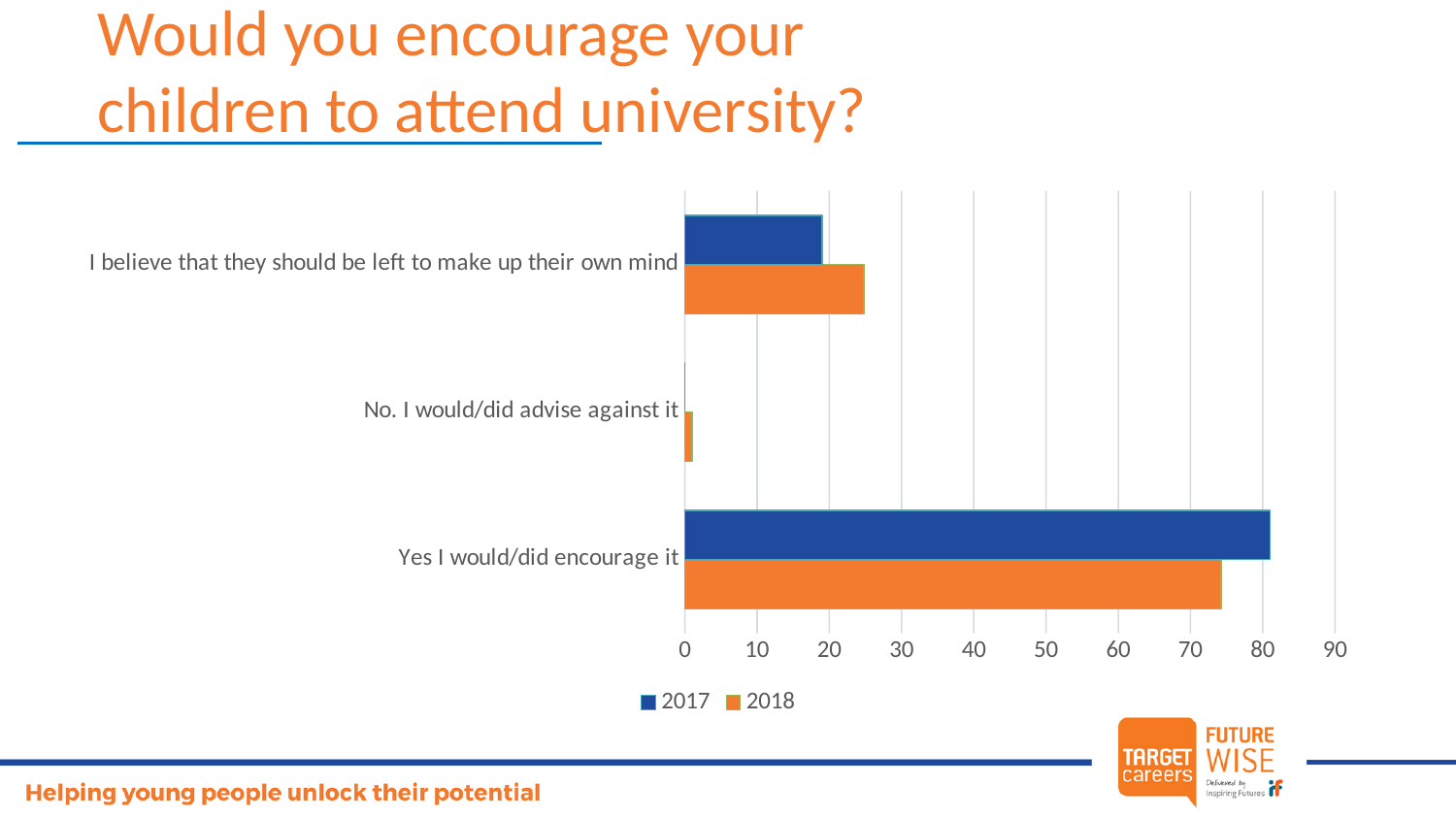
Which response category has the lowest value for 2018? No. I would/did advise against it Which response category has the highest value for 2017? Yes I would/did encourage it What is the title of the slide containing the chart? Would you encourage your children to attend university? How many response categories are shown on the chart? 3 What kind of chart is shown on the slide? bar chart Is the 2017 value for 'Yes I would/did encourage it' greater or less than 80? greater For 'Yes I would/did encourage it', which year has the larger value, 2017 or 2018? 2017 For 'I believe that they should be left to make up their own mind', which year has the larger value, 2017 or 2018? 2018 Is the 2018 value for 'Yes I would/did encourage it' greater or less than 70? greater How many series does the legend list? 2 Is the 2018 value for 'I believe that they should be left to make up their own mind' greater or less than 30? less Which colour represents the 2018 series in the chart? orange